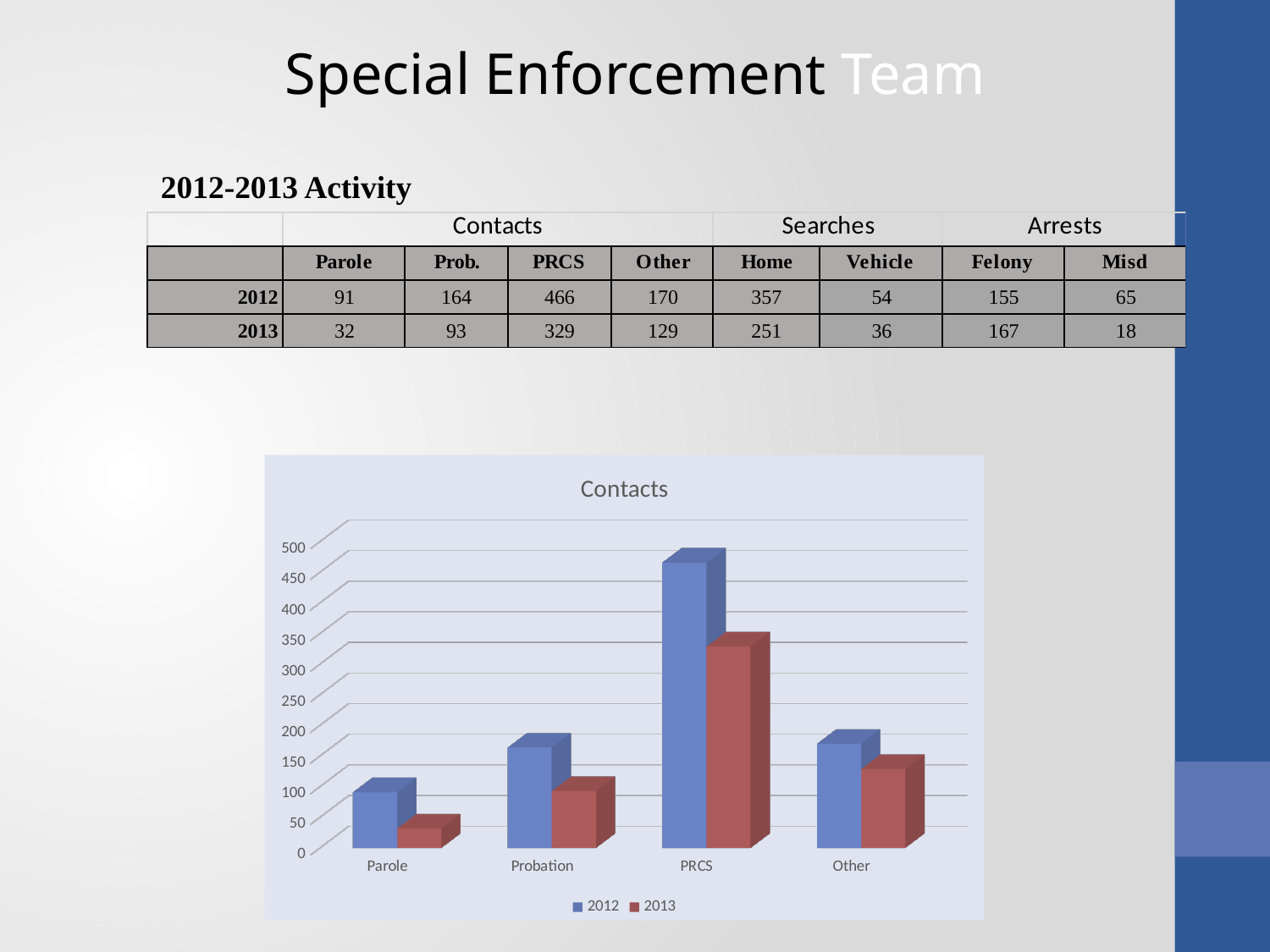
According to the table, what is the 2012 PRCS contacts value plotted in the Contacts chart? 466 What colour are the 2013 bars in the Contacts chart? red Which category has the highest 2012 value in the Contacts chart? PRCS In the Contacts chart, which is larger: the 2012 value for Probation or the 2012 value for Other? Other According to the table, what is the 2013 Probation contacts value plotted in the Contacts chart? 93 How many categories are shown on the x axis of the Contacts chart? 4 In the Contacts chart, is the 2013 value for Parole greater or less than 50? less What type of chart is the Contacts chart? bar chart Using the values in the table, what is the difference between the 2012 and 2013 PRCS contacts shown in the Contacts chart? 137 How many series does the legend of the Contacts chart list? 2 Which category has the lowest 2013 value in the Contacts chart? Parole In the Contacts chart, is the 2012 value for PRCS greater or less than 400? greater